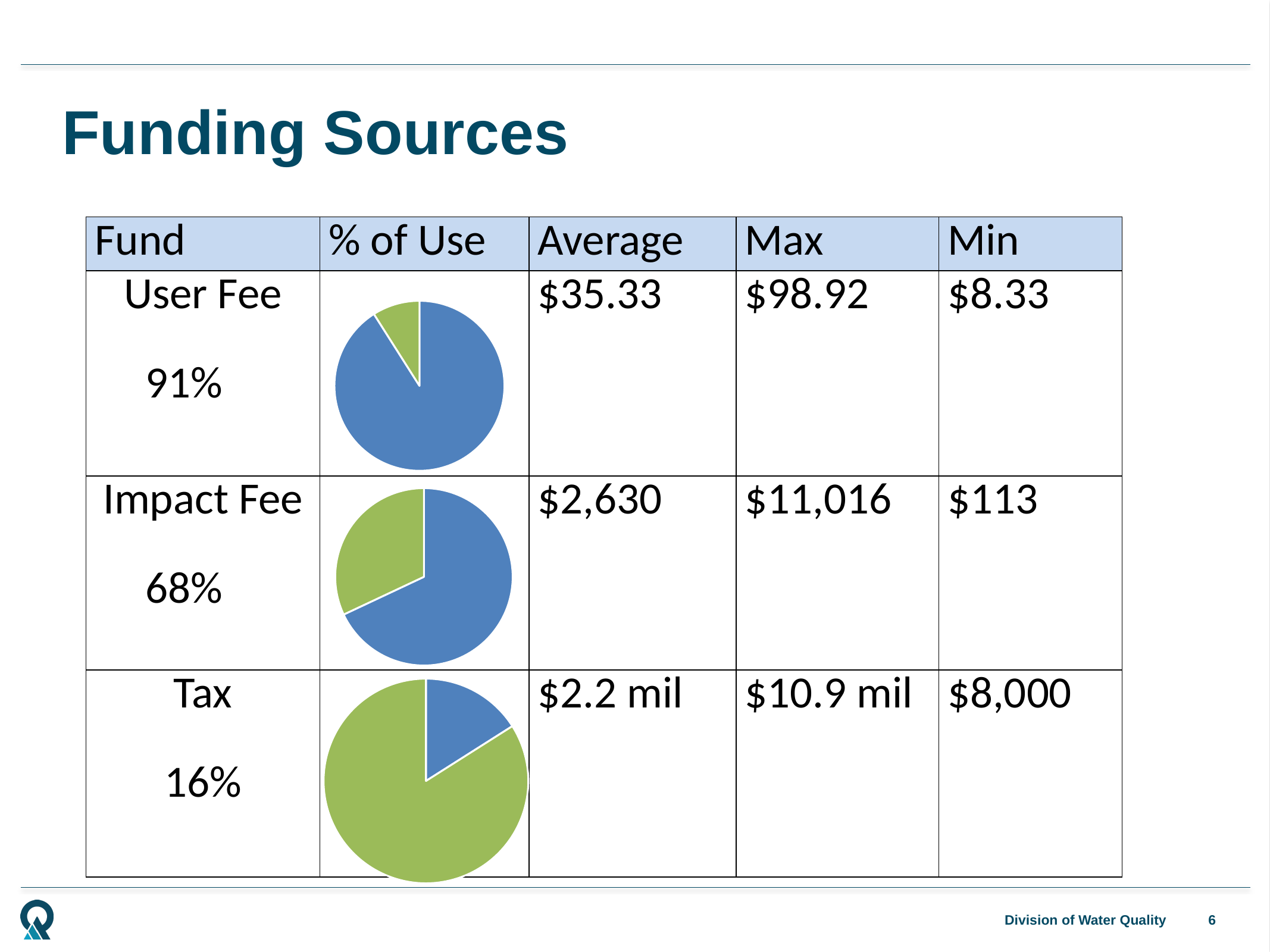
What is the title of the slide containing the pie charts? Funding Sources How many pie charts are shown on the slide? 3 What is the difference in % of Use between User Fee and Tax? 75% What kind of chart is shown in the '% of Use' column for each fund? pie chart How many slices does each pie chart have? 2 In the User Fee pie chart, what share of the pie does the blue slice represent? 91% Which fund's pie chart has the smallest blue slice? Tax In the Tax pie chart, what share of the pie does the blue slice represent? 16% In the Tax pie chart, which colour takes up the majority of the pie? green Is the blue slice larger in the Impact Fee pie chart or the Tax pie chart? Impact Fee In the Impact Fee pie chart, what share of the pie does the blue slice represent? 68% Which fund's pie chart has the largest blue slice? User Fee